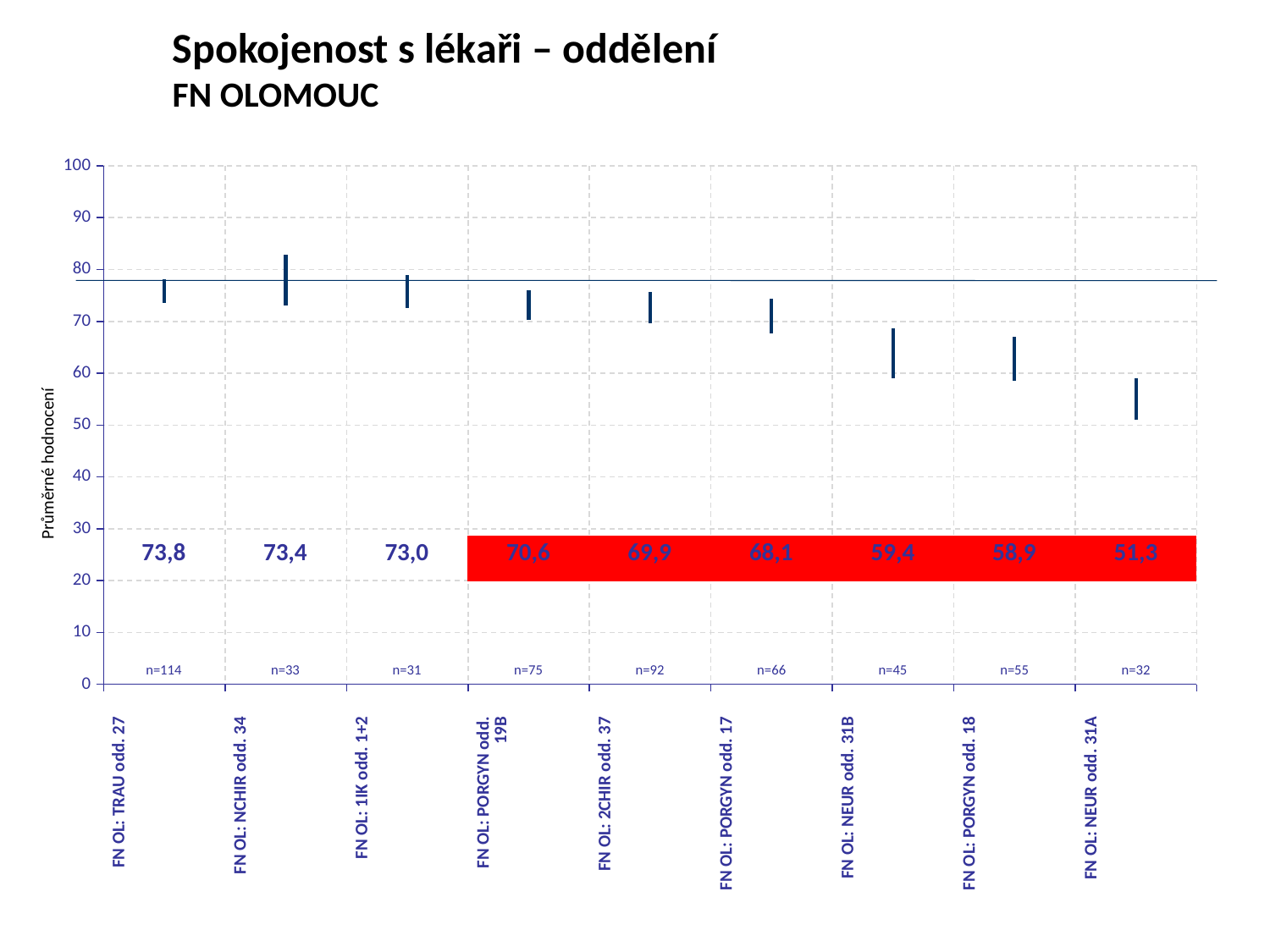
What is the sample size (n) for FN OL: 2CHIR odd. 37? n=92 Do the average ratings rise or fall from left to right along the x axis? fall Which department has the lowest average rating? FN OL: NEUR odd. 31A What is the title of the chart? Spokojenost s lékaři – oddělení FN OLOMOUC What is the average rating for FN OL: NEUR odd. 31A? 51,3 What is the difference between the average ratings of FN OL: PORGYN odd. 19B and FN OL: PORGYN odd. 18? 11,7 What is the average rating for FN OL: TRAU odd. 27? 73,8 How many departments are shown on the chart? 9 What is the average rating for FN OL: PORGYN odd. 17? 68,1 Which department has the highest average rating? FN OL: TRAU odd. 27 What is the difference between the average ratings of FN OL: TRAU odd. 27 and FN OL: NEUR odd. 31A? 22,5 Which has a higher average rating, FN OL: 2CHIR odd. 37 or FN OL: NEUR odd. 31B? FN OL: 2CHIR odd. 37